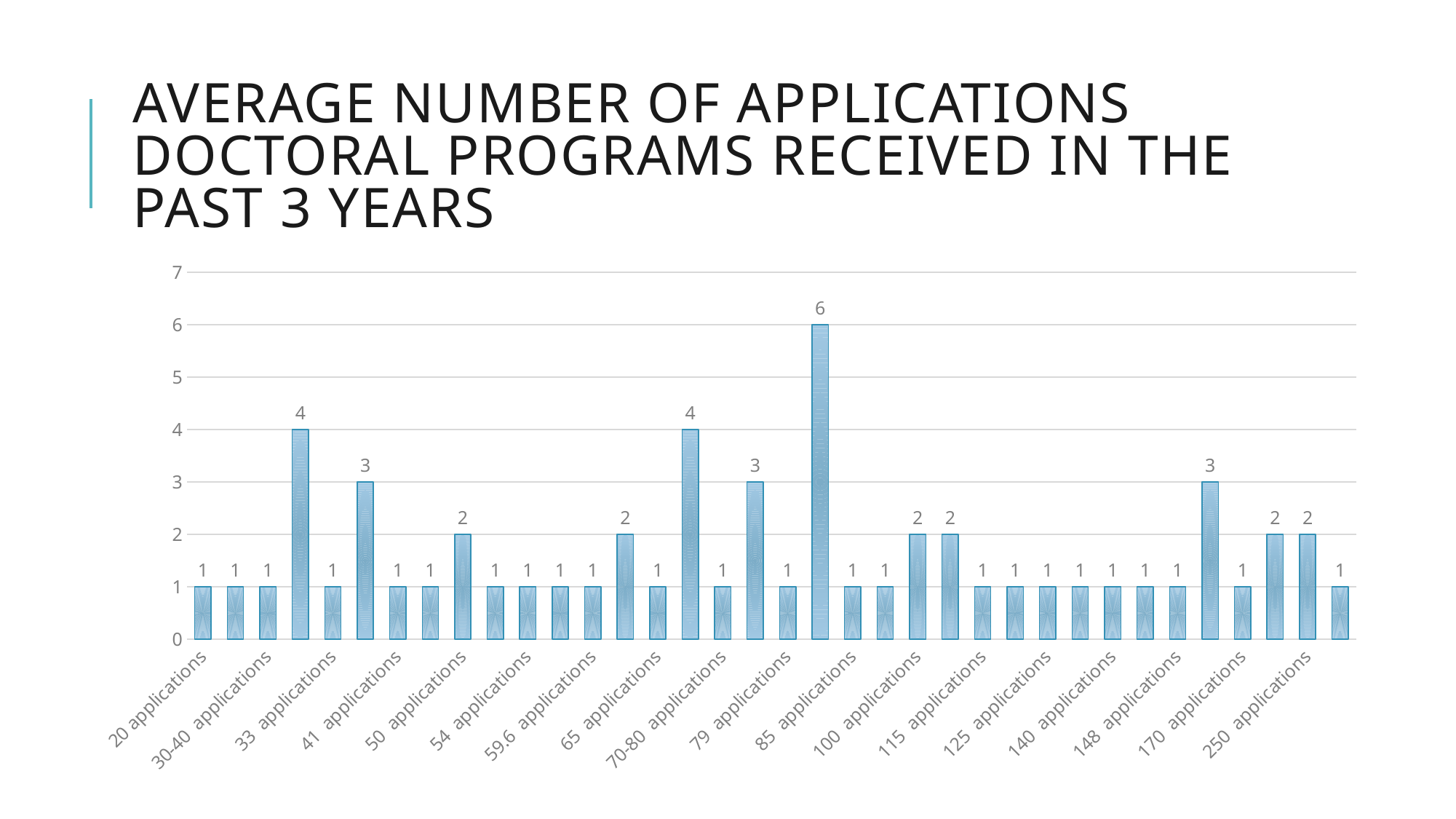
What is the difference between the tallest bar's value and the shortest bar's value? 5 What is the highest value shown by any bar in the chart? 6 How many bars have a value of 3? 3 What is the highest tick value on the vertical axis? 7 Which value occurs most often among the bars? 1 How many bars reach a value of 6? 1 Is the tallest bar's value greater or less than 5? greater What is the lowest value shown by any bar in the chart? 1 How many bars are plotted in the chart? 36 What is the title of the slide containing the chart? Average Number of Applications Doctoral Programs Received in the Past 3 Years What kind of chart is shown on the slide? bar chart